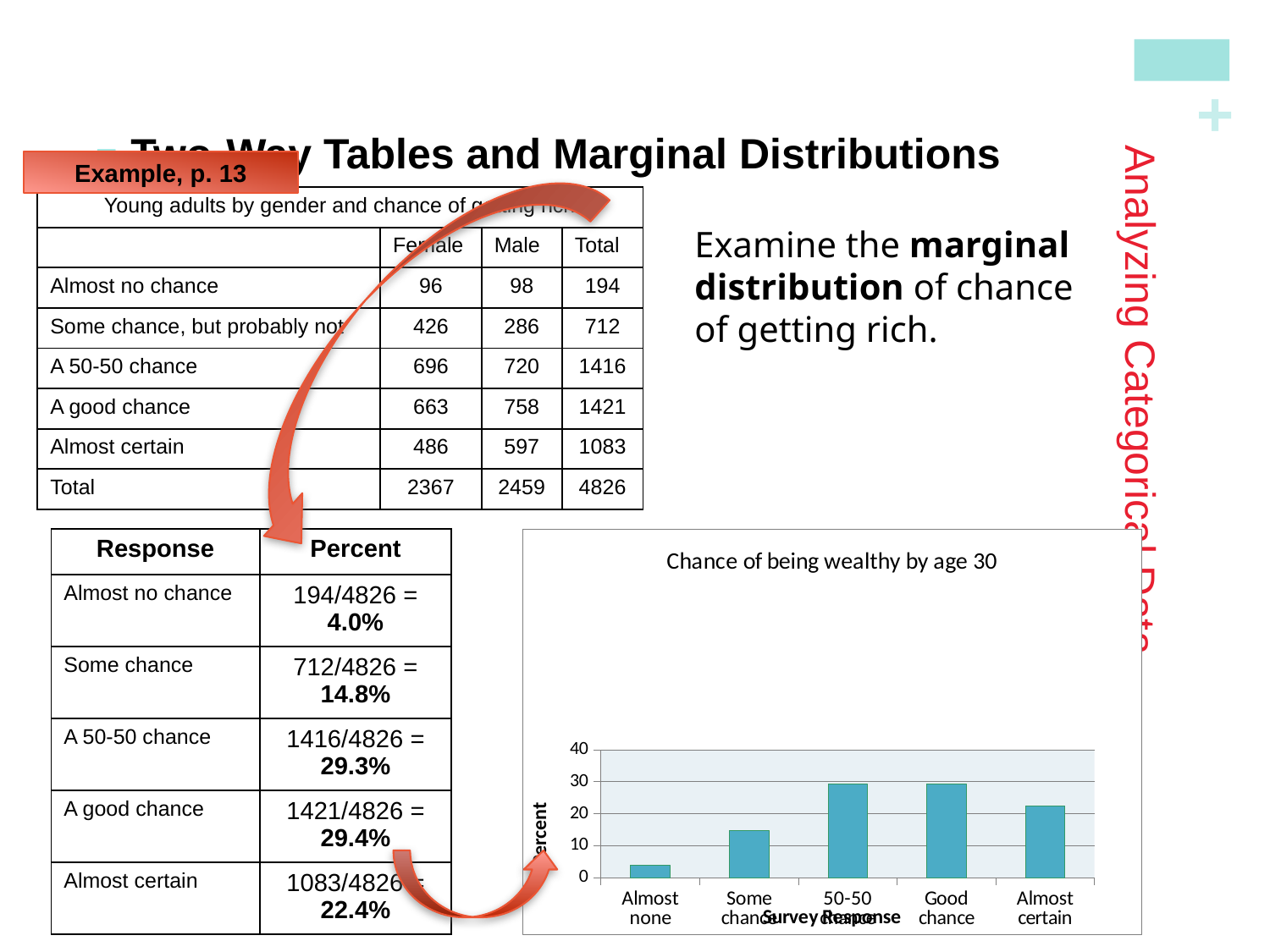
What kind of chart is shown on the slide? bar chart Is the value for Good chance greater or less than 20? greater Is the value for Some chance greater or less than 20? less Is the value for 50-50 chance greater or less than 20? greater Which category has the lowest bar in the chart? Almost none Which is larger, the bar for Some chance or the bar for Almost certain? Almost certain What is the title of the bar chart? Chance of being wealthy by age 30 How many categories are shown on the x axis of the bar chart? 5 Which is larger, the bar for Almost none or the bar for Some chance? Some chance What is the label on the y axis of the bar chart? Percent